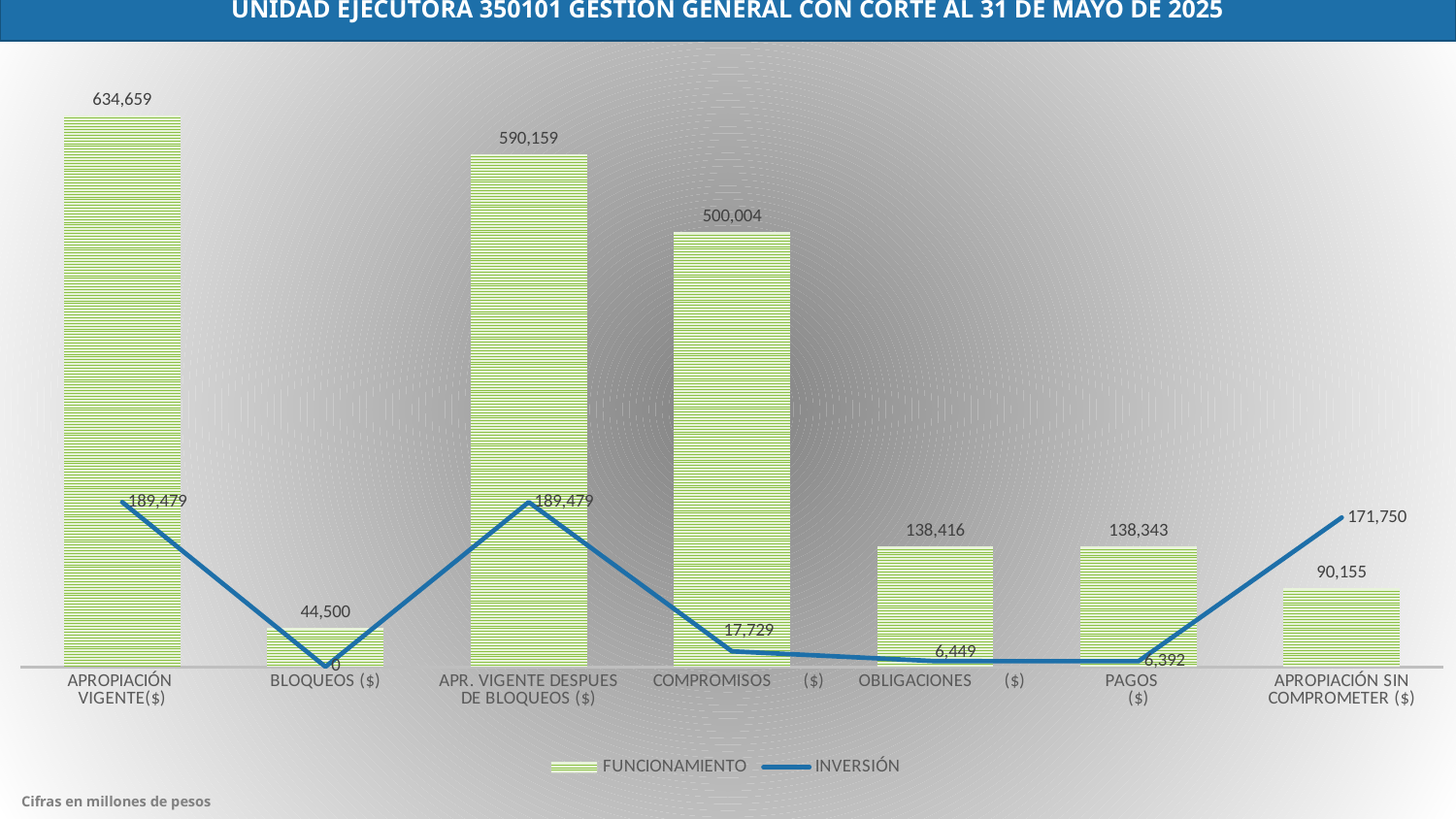
What is the difference between the INVERSIÓN values for APR. VIGENTE DESPUES DE BLOQUEOS ($) and APROPIACIÓN SIN COMPROMETER ($)? 17,729 How many series does the legend list? 2 Which is larger, the FUNCIONAMIENTO value for COMPROMISOS ($) or for APR. VIGENTE DESPUES DE BLOQUEOS ($)? APR. VIGENTE DESPUES DE BLOQUEOS ($) What is the INVERSIÓN value for APROPIACIÓN SIN COMPROMETER ($)? 171,750 What kind of chart is shown on the slide? Combined bar and line chart What is the INVERSIÓN value for OBLIGACIONES ($)? 6,449 What is the difference between the FUNCIONAMIENTO values for APROPIACIÓN VIGENTE($) and APR. VIGENTE DESPUES DE BLOQUEOS ($)? 44,500 What is the FUNCIONAMIENTO value for COMPROMISOS ($)? 500,004 Which category has the highest FUNCIONAMIENTO value? APROPIACIÓN VIGENTE($) How many categories are shown on the x axis? 7 Which category has the lowest INVERSIÓN value? BLOQUEOS ($) What is the FUNCIONAMIENTO value for APROPIACIÓN VIGENTE($)? 634,659